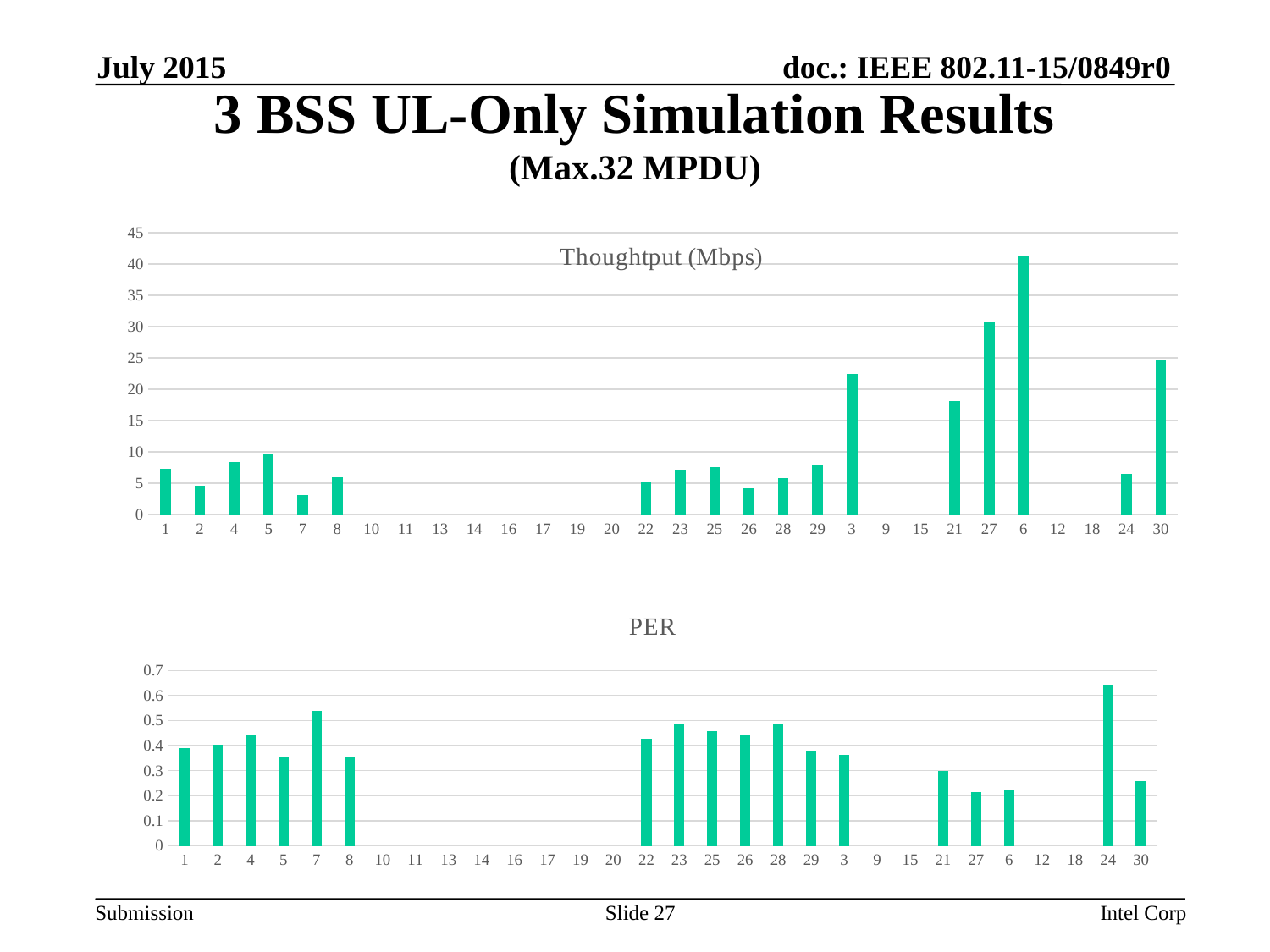
In the top chart (Thoughtput (Mbps)), is the value for category 3 greater or less than 20? greater In the top chart (Thoughtput (Mbps)), is the value for category 21 greater or less than 20? less What is the title of the top chart? Thoughtput (Mbps) In the bottom chart (PER), which is larger, the value for category 7 or category 8? 7 In the top chart (Thoughtput (Mbps)), which is larger, the value for category 6 or category 27? 6 In the bottom chart (PER), is the value for category 7 greater or less than 0.5? greater How many categories are shown on the x axis of the bottom chart (PER)? 30 What kind of chart is the top chart titled "Thoughtput (Mbps)"? bar chart In the bottom chart (PER), which category has the highest value? 24 In the top chart (Thoughtput (Mbps)), which category has the highest value? 6